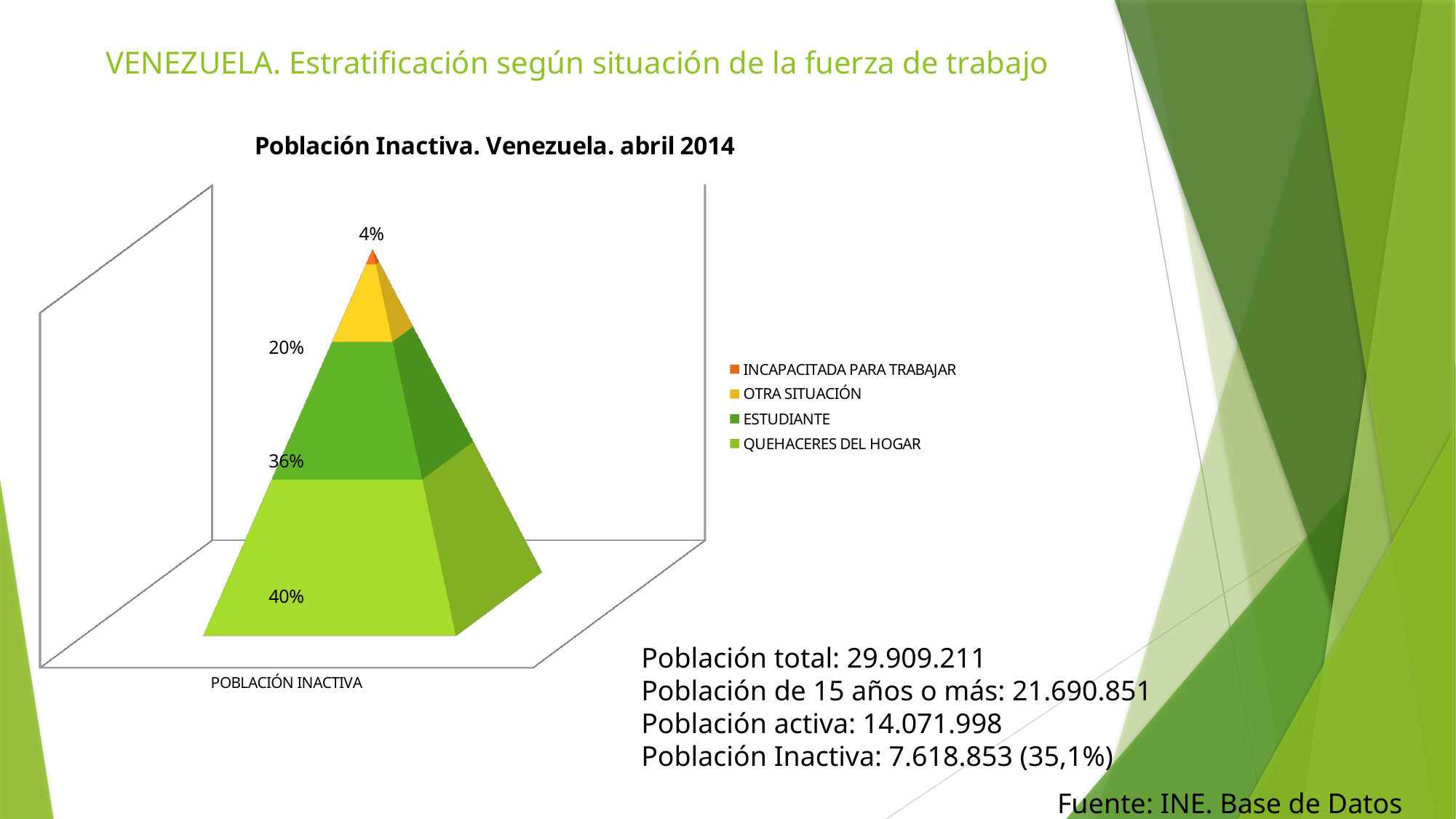
Which series has the smallest share in the chart? INCAPACITADA PARA TRABAJAR What percentage does the chart show for ESTUDIANTE? 36% What percentage does the chart show for INCAPACITADA PARA TRABAJAR? 4% What is the title of the chart? Población Inactiva. Venezuela. abril 2014 What is the total of the stacked segments for POBLACIÓN INACTIVA? 100% What percentage does the chart show for QUEHACERES DEL HOGAR? 40% Which is larger, the share for ESTUDIANTE or the share for OTRA SITUACIÓN? ESTUDIANTE What percentage does the chart show for OTRA SITUACIÓN? 20% How many series does the legend list? 4 Which series has the largest share in the chart? QUEHACERES DEL HOGAR What is the category label shown on the x axis of the chart? POBLACIÓN INACTIVA What is the difference between the ESTUDIANTE share and the OTRA SITUACIÓN share? 16%